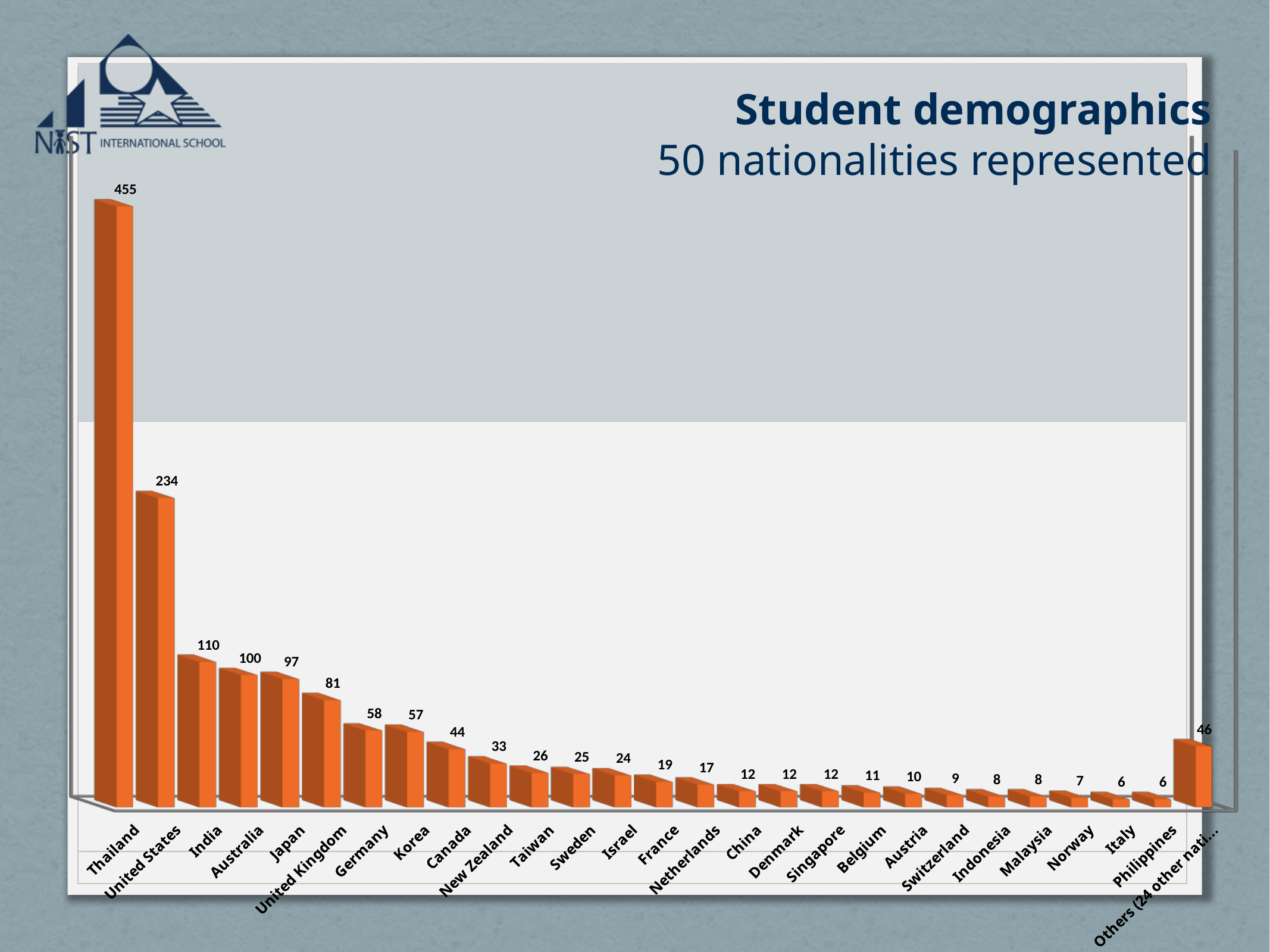
How many bars are plotted in the chart? 27 Which nationality has the highest value? Thailand What is the subtitle of the slide below 'Student demographics'? 50 nationalities represented What is the value for Japan? 97 What is the value for the 'Others (24 other nati...)' bar? 46 What kind of chart is shown on the slide? bar chart How many students are from Thailand? 455 What is the value for the United States? 234 What is the difference between the values for India and Australia? 10 What is the value for New Zealand? 33 Which is larger, the value for Germany or the value for Korea? Germany What is the difference between the values for Thailand and the United States? 221